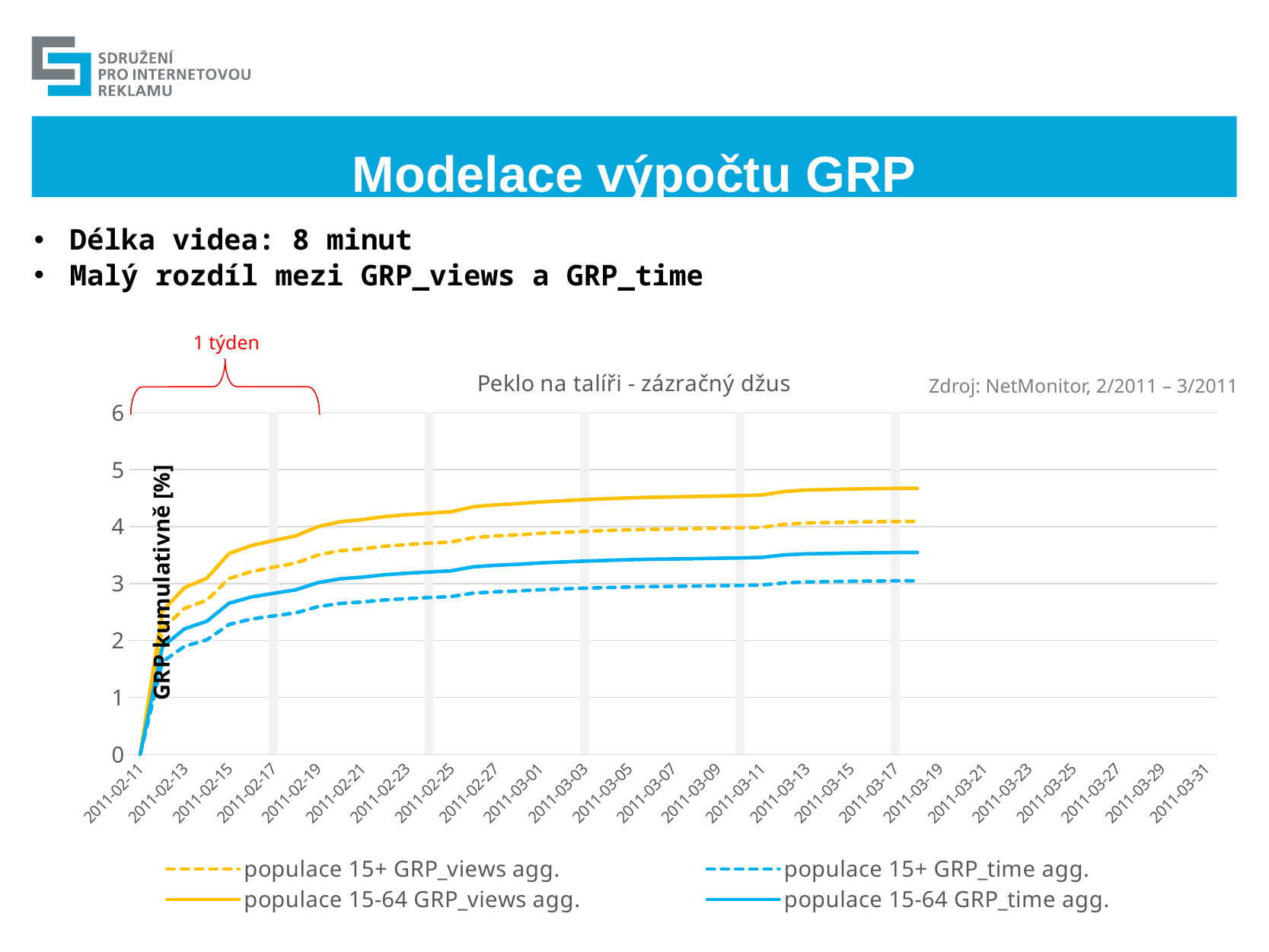
What is the label of the vertical axis of the chart? GRP kumulativně [%] What kind of chart is shown on the slide? line chart What is the title of the chart? Peklo na talíři - zázračný džus Is the final value for populace 15-64 GRP_views agg. greater or less than 4? greater Is the final value for populace 15+ GRP_time agg. greater or less than 4? less Is the final value for populace 15-64 GRP_time agg. greater or less than 4? less Which series has the highest value at the end of the plotted period? populace 15-64 GRP_views agg. At the end of the plotted period, which is larger: populace 15-64 GRP_views agg. or populace 15+ GRP_time agg.? populace 15-64 GRP_views agg. Do the plotted values rise or fall along the x axis over time? rise How many series does the chart legend list? 4 Which series has the lowest value at the end of the plotted period? populace 15+ GRP_time agg.